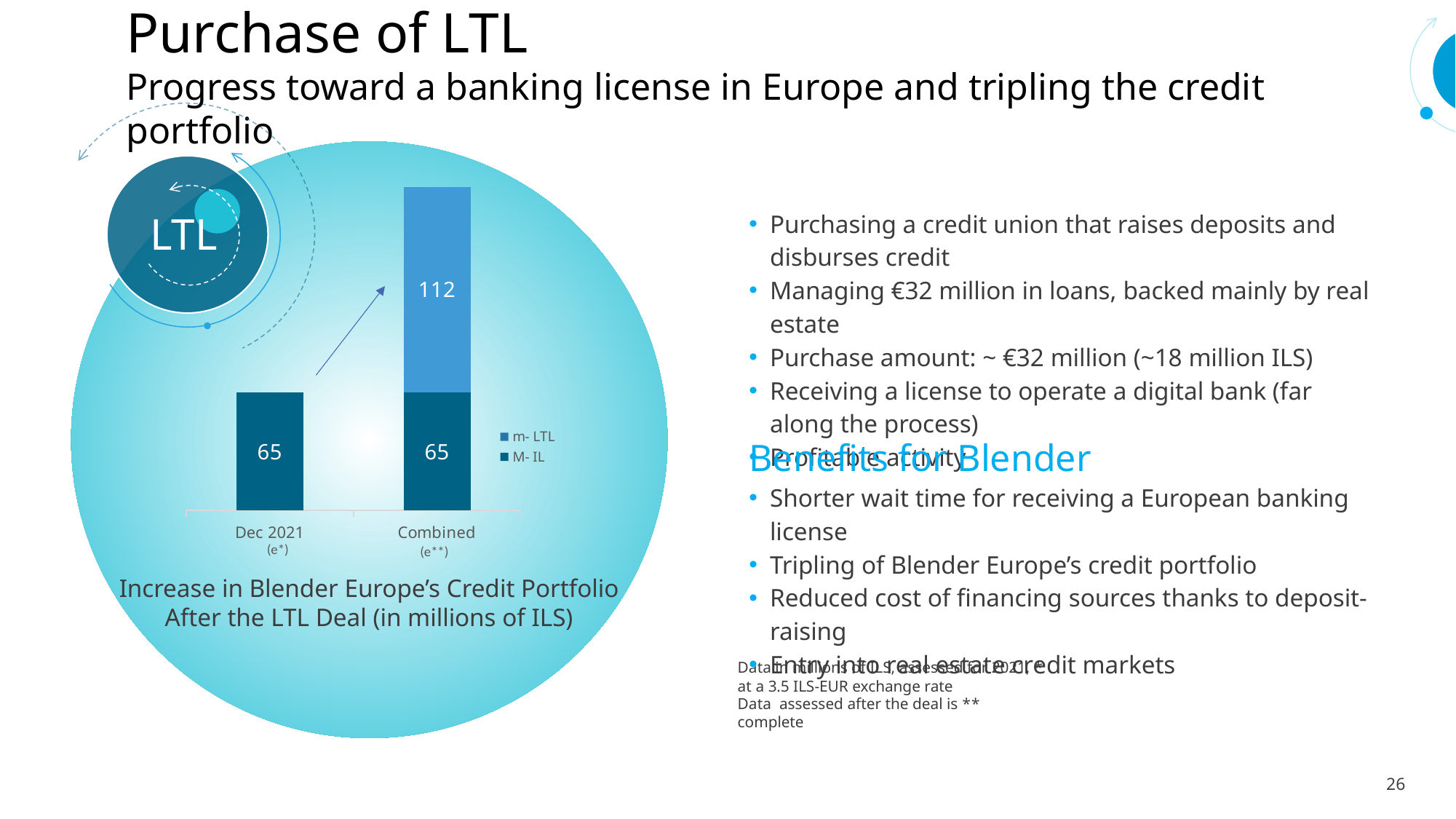
How many categories are shown on the x axis of the chart? 2 What is the value of the M- IL series for Dec 2021? 65 What are the two series names listed in the chart legend? m- LTL and M- IL What is the value of the M- IL series in the Combined bar? 65 What is the value of the m- LTL series for the Combined bar? 112 What is the difference between the m- LTL value and the M- IL value in the Combined bar? 47 What is the total of the Combined stacked bar? 177 Which category has the highest total bar value? Combined Which is larger in the Combined bar, the m- LTL segment or the M- IL segment? m- LTL How many series does the chart legend list? 2 Do the total bar values rise or fall from Dec 2021 to Combined? Rise What type of chart is shown on the slide? Stacked bar chart